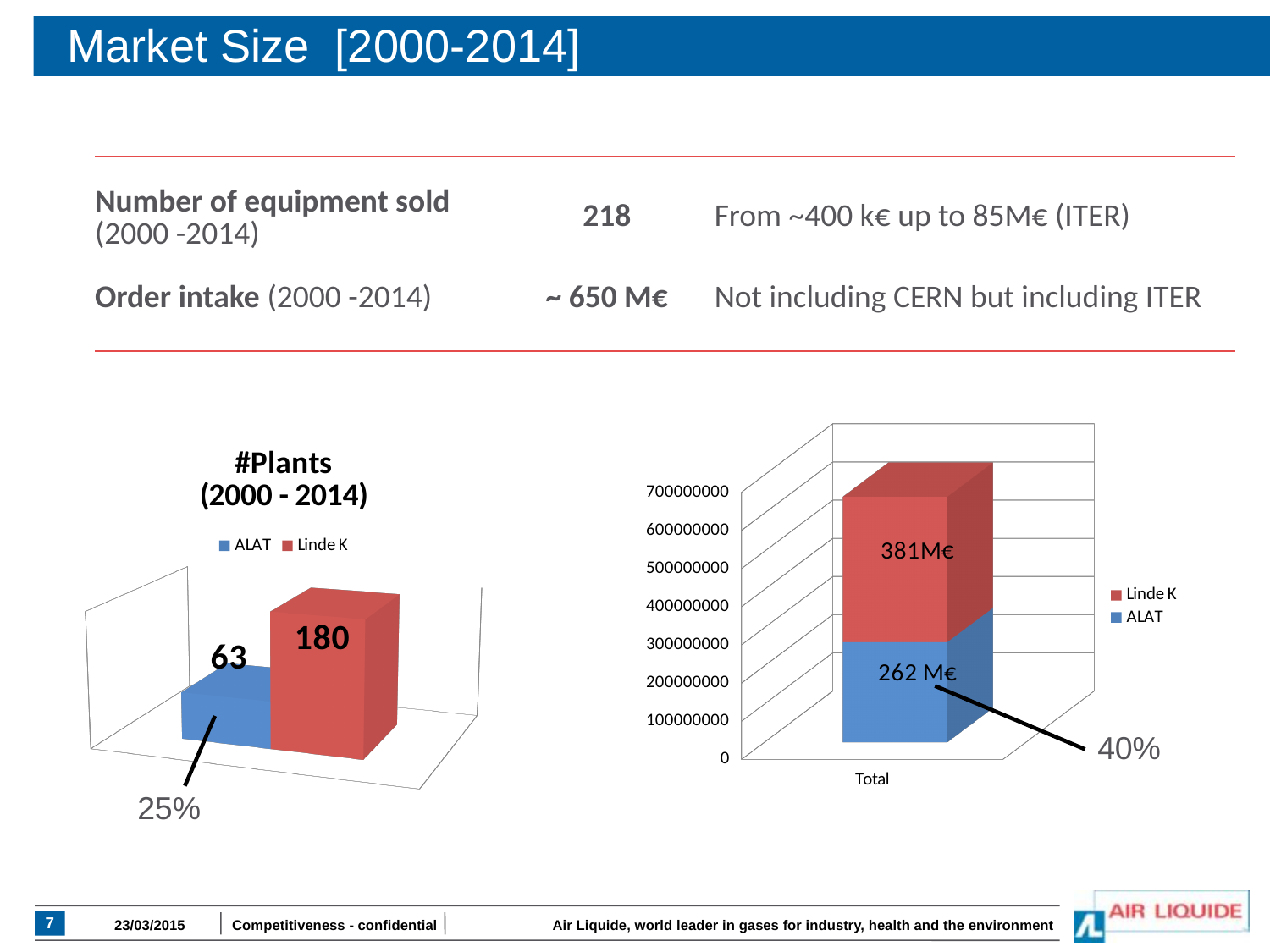
In the #Plants (2000 - 2014) chart, what is the value for Linde K? 180 In the chart on the right of the slide, what is the category label on the x axis? Total In the chart on the right of the slide, is the top of the stacked bar greater or less than 600000000? greater In the chart on the right of the slide, which series is shown in blue? ALAT In the #Plants (2000 - 2014) chart, how many series does the legend list? 2 In the chart on the right of the slide, what is the value labelled for ALAT? 262 M€ In the #Plants (2000 - 2014) chart, what is the difference between the Linde K and ALAT values? 117 In the #Plants (2000 - 2014) chart, which series has the higher number of plants? Linde K What kind of chart is the #Plants (2000 - 2014) chart? Bar chart In the chart on the right of the slide, which series has the larger value, Linde K or ALAT? Linde K In the chart on the right of the slide, what is the value labelled for Linde K? 381M€ In the #Plants (2000 - 2014) chart, what is the value for ALAT? 63